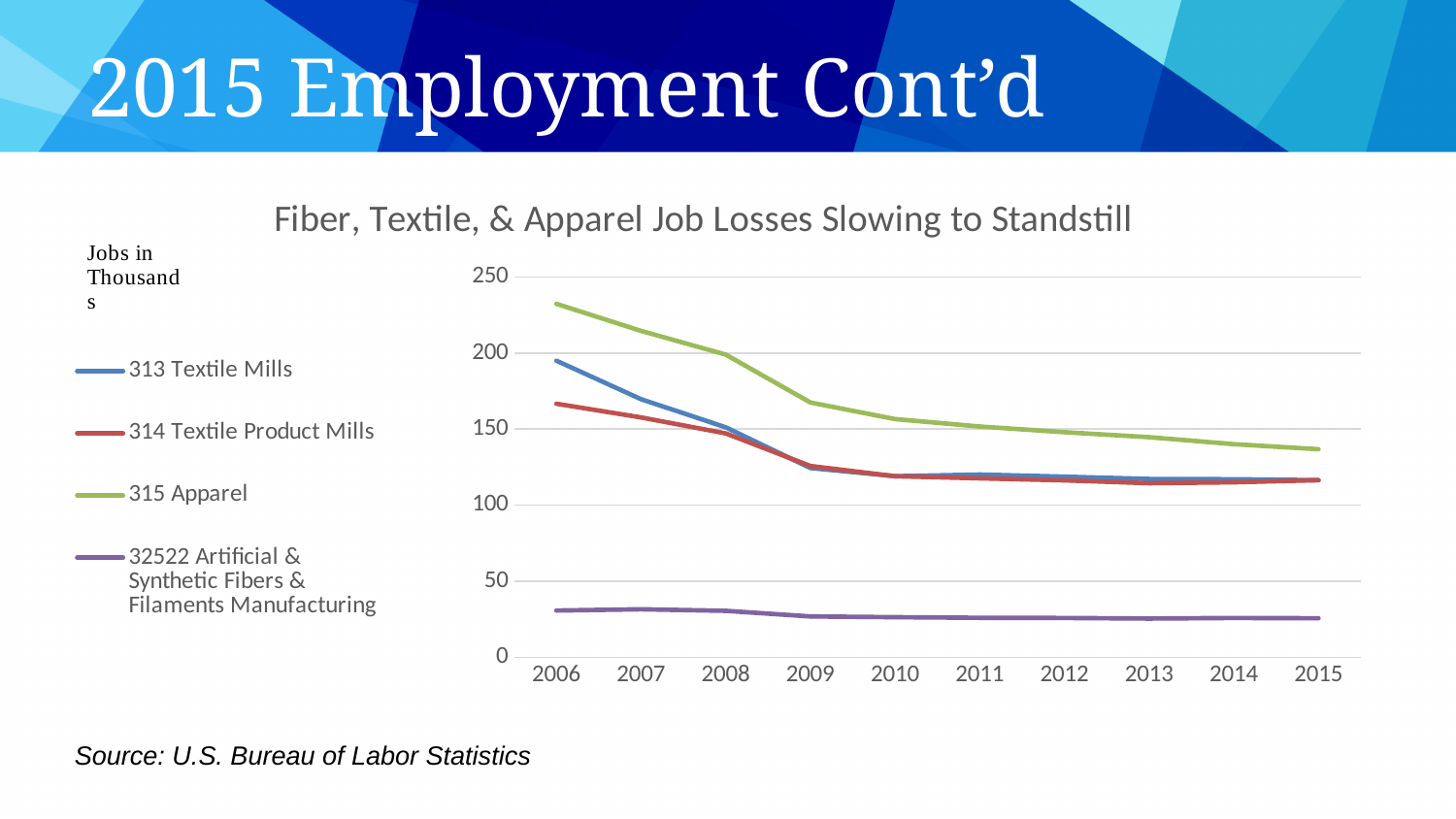
Does the 315 Apparel line rise or fall from 2006 to 2015? fall Is the value for 315 Apparel in 2006 greater or less than 200? greater What kind of chart is shown on the slide? line chart Is the value for 32522 Artificial & Synthetic Fibers & Filaments Manufacturing in 2006 greater or less than 50? less Is the value for 315 Apparel in 2015 greater or less than 150? less How many series does the legend list? 4 Which series has the highest value in 2006? 315 Apparel How many years are shown along the x axis? 10 Which series has the lowest value across all years shown? 32522 Artificial & Synthetic Fibers & Filaments Manufacturing In 2006, which is larger: 313 Textile Mills or 314 Textile Product Mills? 313 Textile Mills What is the title of the chart? Fiber, Textile, & Apparel Job Losses Slowing to Standstill